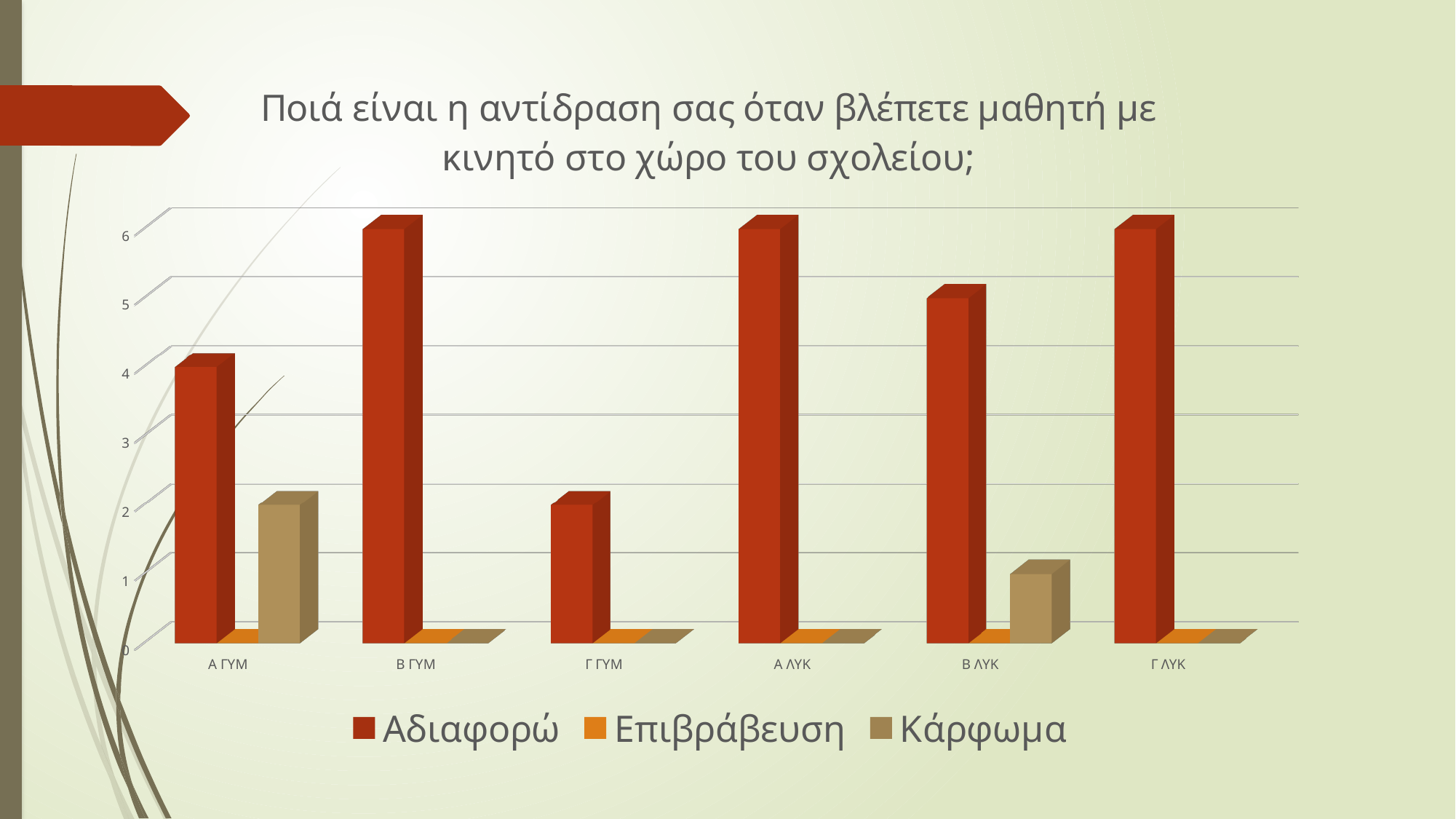
Is the value for Κάρφωμα at Α ΓΥΜ greater or less than 3? less Is the value for Αδιαφορώ at Β ΛΥΚ greater or less than 4? greater Is the value for Αδιαφορώ at Γ ΓΥΜ greater or less than 3? less Which category has the lowest value for Αδιαφορώ? Γ ΓΥΜ Which is larger, the Κάρφωμα value for Α ΓΥΜ or for Β ΛΥΚ? Α ΓΥΜ How many categories are shown on the x axis? 6 Which series has the highest value at Β ΛΥΚ? Αδιαφορώ Which is larger, the Αδιαφορώ value for Β ΓΥΜ or for Γ ΓΥΜ? Β ΓΥΜ How many series does the legend list? 3 What kind of chart is shown on the slide? bar chart Which series is shown in red? Αδιαφορώ